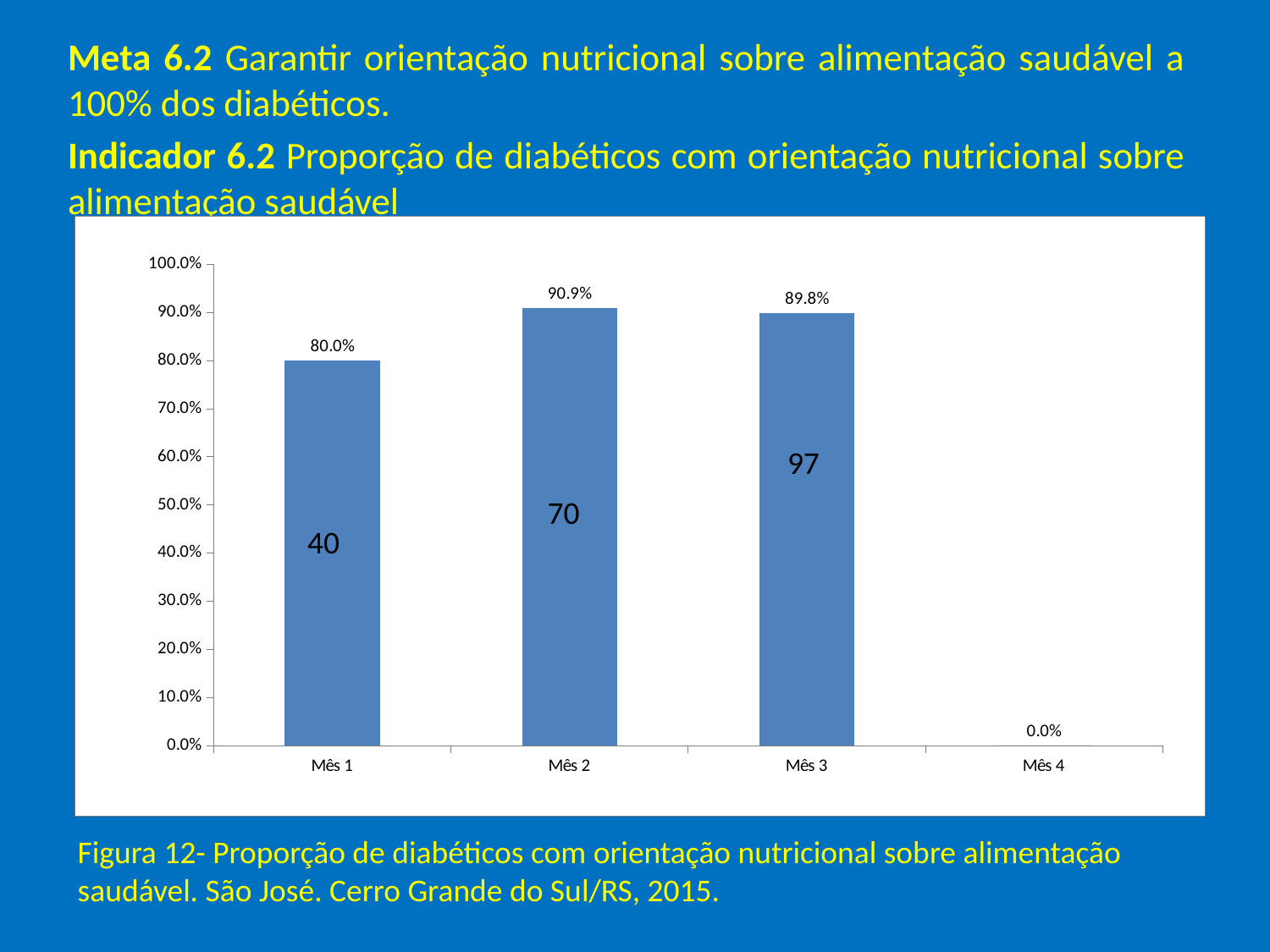
Which month has the lowest value? Mês 4 What is the value for Mês 1? 80.0% What number is printed inside the bar for Mês 3? 97 How many months are shown on the x axis? 4 Which month has the highest value? Mês 2 What is the value for Mês 3? 89.8% What is the difference between the values for Mês 2 and Mês 1? 10.9% Which is larger, the value for Mês 1 or the value for Mês 3? Mês 3 What kind of chart is shown on the slide? Bar chart What is the highest value shown on the y axis? 100.0% What is the value for Mês 2? 90.9% What is the value for Mês 4? 0.0%